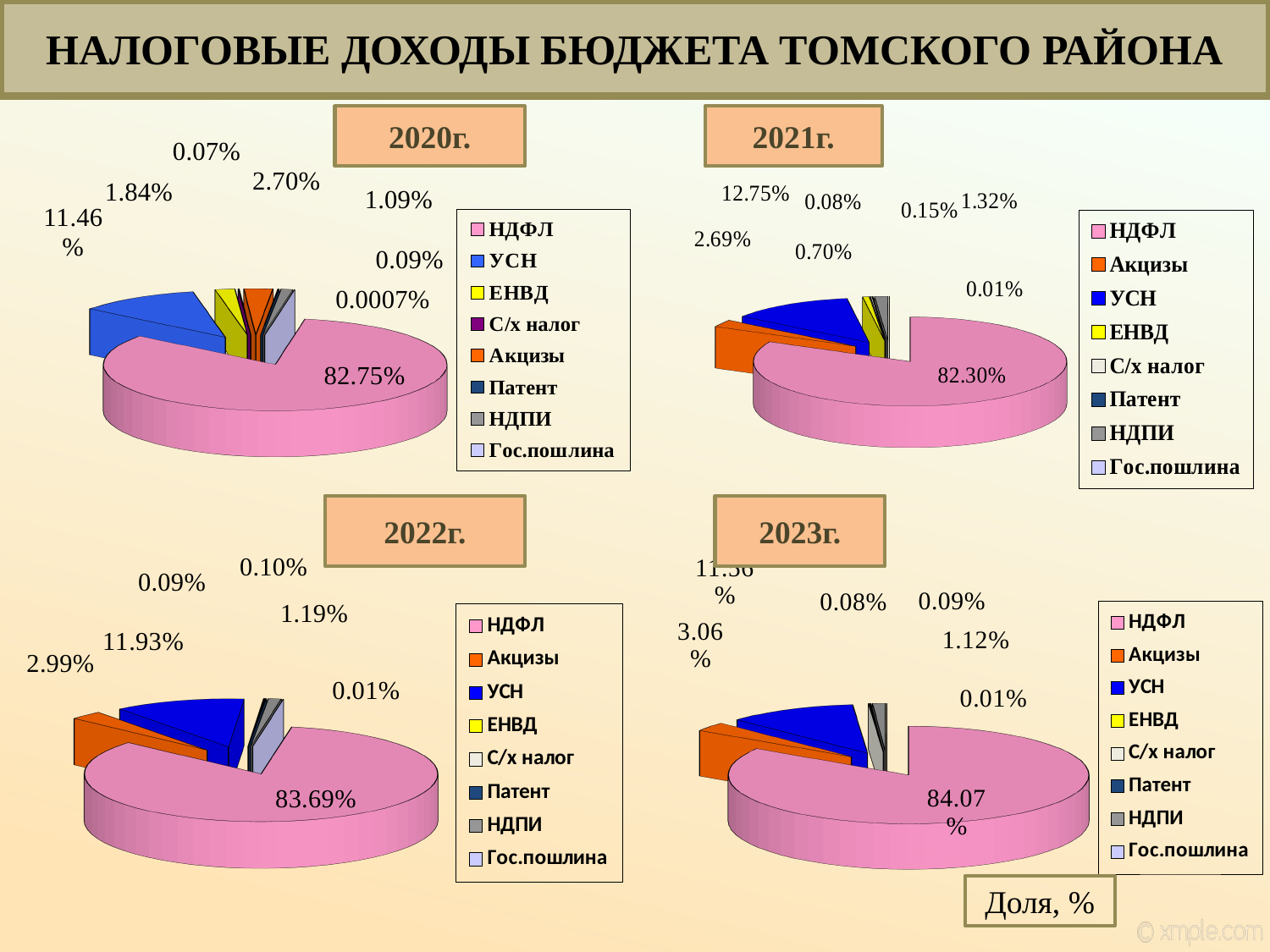
Which is larger: the НДФЛ share in the 2020г. chart or in the 2023г. chart? 2023г. In the 2021г. chart, what share does УСН have? 12.75% In the 2021г. chart, what share does НДФЛ have? 82.30% In the 2023г. chart, what share does НДФЛ have? 84.07% In the 2020г. chart, what share does УСН have? 11.46% What kind of chart is used on this slide to show the tax revenue shares? Pie chart In the 2022г. chart, what share does НДФЛ have? 83.69% In the 2023г. chart, which category has the largest share? НДФЛ In the 2022г. chart, what share does Акцизы have? 2.99% How many pie charts are shown on the slide? 4 How many entries does the legend of the 2021г. chart list? 8 In the 2020г. chart, what share does НДФЛ have? 82.75%